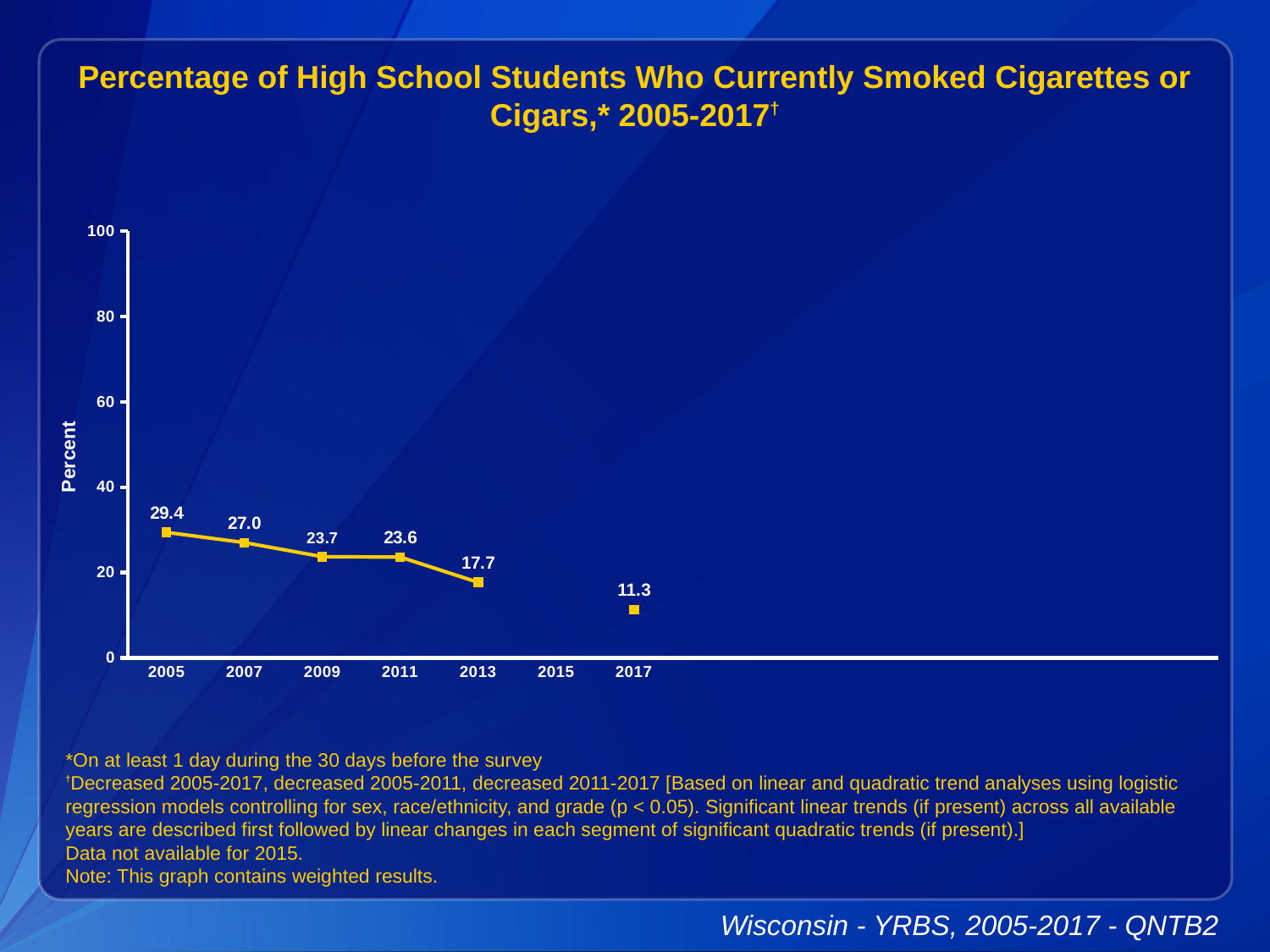
What is the value plotted for 2017? 11.3 Which year has the lowest percentage? 2017 Is the value for 2005 greater or less than 20? greater What kind of chart is shown on the slide? line chart What percentage of high school students currently smoked cigarettes or cigars in 2005? 29.4 Do the values rise or fall from 2005 to 2017? fall Which year has the highest percentage? 2005 What is the difference between the 2013 value and the 2017 value? 6.4 How many years have a data point plotted on the chart? 6 What is the value plotted for 2011? 23.6 Which year has a larger value, 2007 or 2013? 2007 What is the difference between the 2005 value and the 2017 value? 18.1